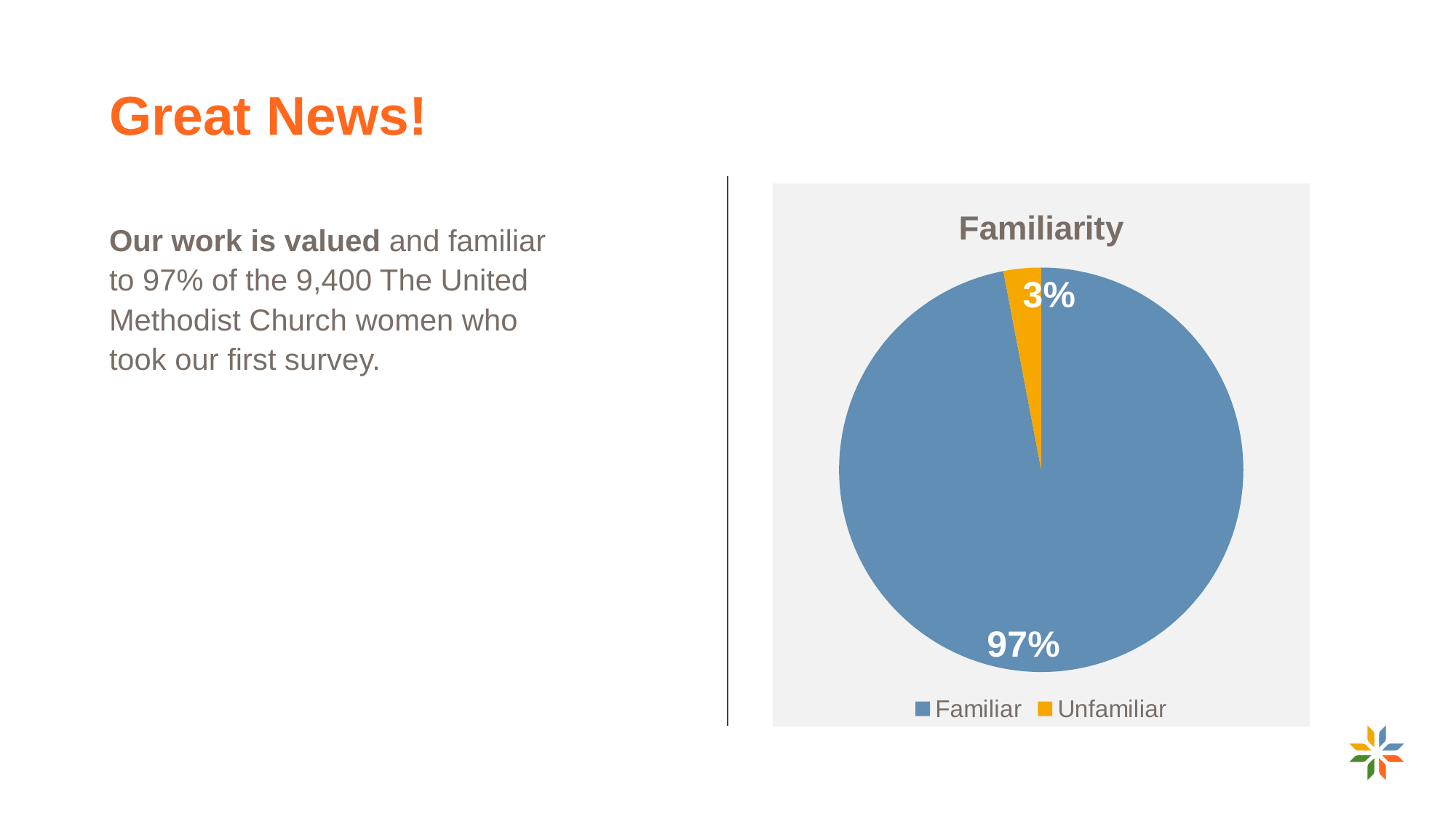
What share of the pie is labelled Familiar? 97% Which slice of the pie is the largest? Familiar Which slice of the pie is the smallest? Unfamiliar Which is larger, the Familiar slice or the Unfamiliar slice? Familiar What is the difference between the Familiar and Unfamiliar shares? 94% What kind of chart is shown on the slide? pie chart How many slices does the pie chart have? 2 What is the total of the two slices shown in the pie chart? 100% What colour is the Unfamiliar slice? orange What share of the pie is labelled Unfamiliar? 3% What is the title of the chart? Familiarity How many entries does the legend list? 2